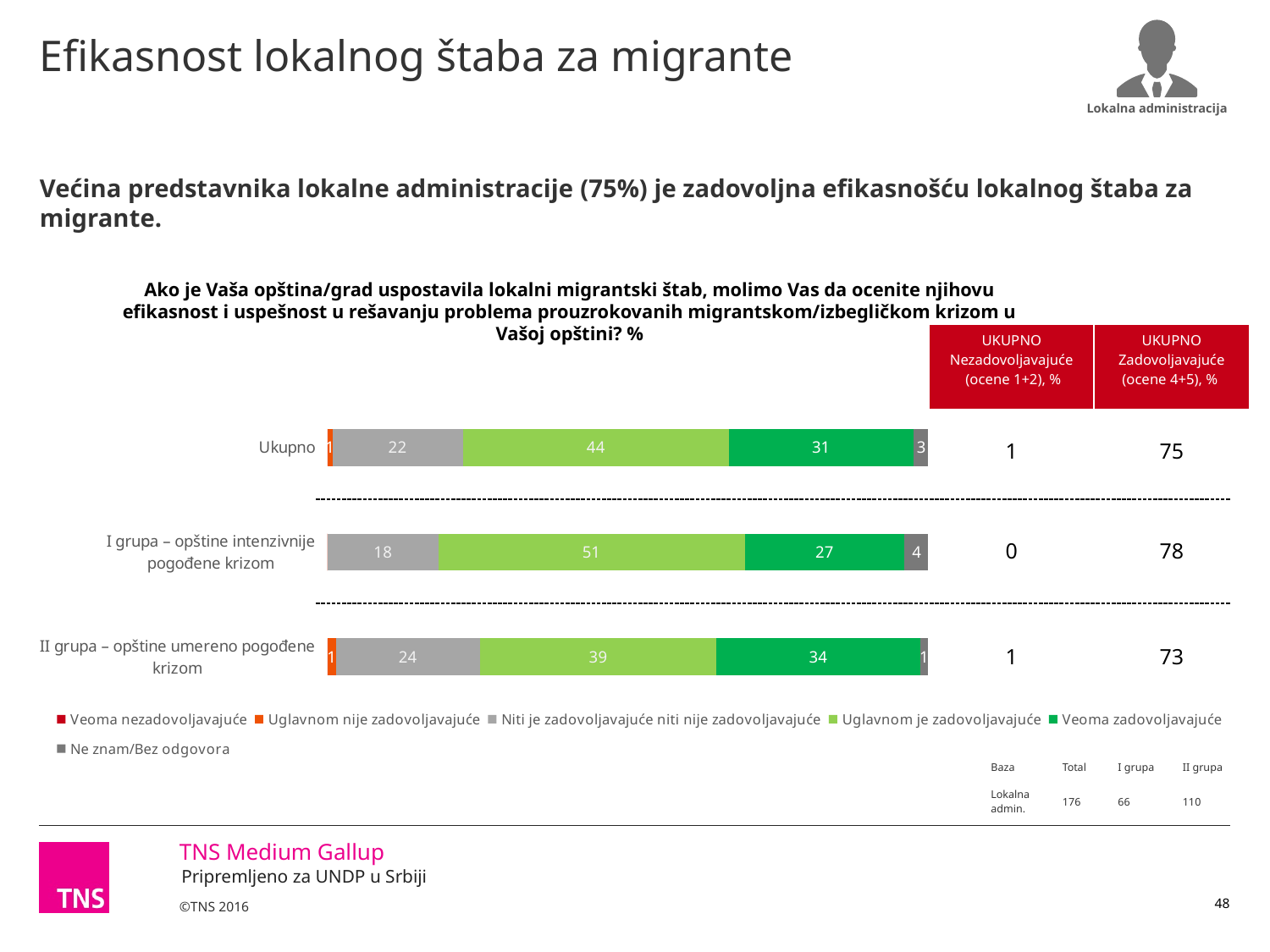
How many categories (rows) does the bar chart show? 3 What is the value of 'Niti je zadovoljavajuće niti nije zadovoljavajuće' for 'II grupa – opštine umereno pogođene krizom'? 24 What is the value of 'Uglavnom je zadovoljavajuće' for 'Ukupno'? 44 What is the value of 'Veoma zadovoljavajuće' for 'I grupa – opštine intenzivnije pogođene krizom'? 27 What is the 'UKUPNO Nezadovoljavajuće (ocene 1+2), %' value for 'Ukupno'? 1 What is the 'UKUPNO Zadovoljavajuće (ocene 4+5), %' value for 'I grupa – opštine intenzivnije pogođene krizom'? 78 Which category has the highest value for 'Uglavnom je zadovoljavajuće'? I grupa – opštine intenzivnije pogođene krizom How many series does the legend list? 6 Which is larger: 'Veoma zadovoljavajuće' for 'Ukupno' or for 'II grupa – opštine umereno pogođene krizom'? II grupa – opštine umereno pogođene krizom What is the difference between the 'Uglavnom je zadovoljavajuće' values for 'I grupa' and 'II grupa'? 12 What type of chart is shown on the slide? Stacked bar chart Which category has the lowest value for 'Veoma zadovoljavajuće'? I grupa – opštine intenzivnije pogođene krizom